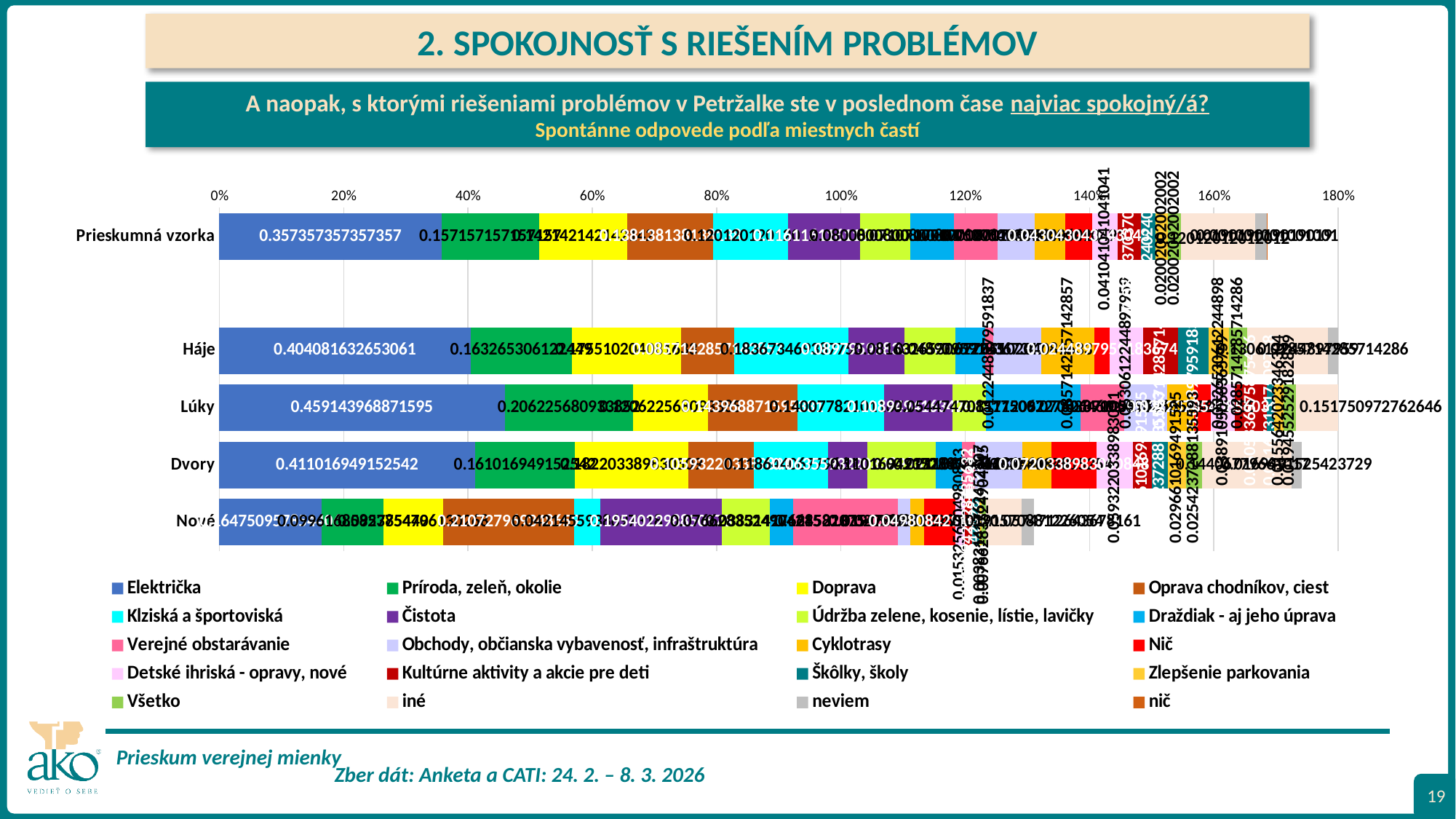
Which is larger, the Električka value for Lúky or for Háje? Lúky Which category has the highest value for Električka? Lúky How many series does the legend list? 20 What is the value of Električka for Prieskumná vzorka? 0.357357357357357 What is the value of Električka for Háje? 0.404081632653061 What is the value of Električka for Lúky? 0.459143968871595 How many categories (rows) are plotted on the chart? 5 Which colour represents Električka in the legend? Blue What type of chart is shown on the slide? Stacked bar chart What is the difference between the Električka values for Lúky and Dvory? 0.048127019719053 What is the value of Príroda, zeleň, okolie for Prieskumná vzorka? 0.157157157157157 What is the value of Električka for Dvory? 0.411016949152542